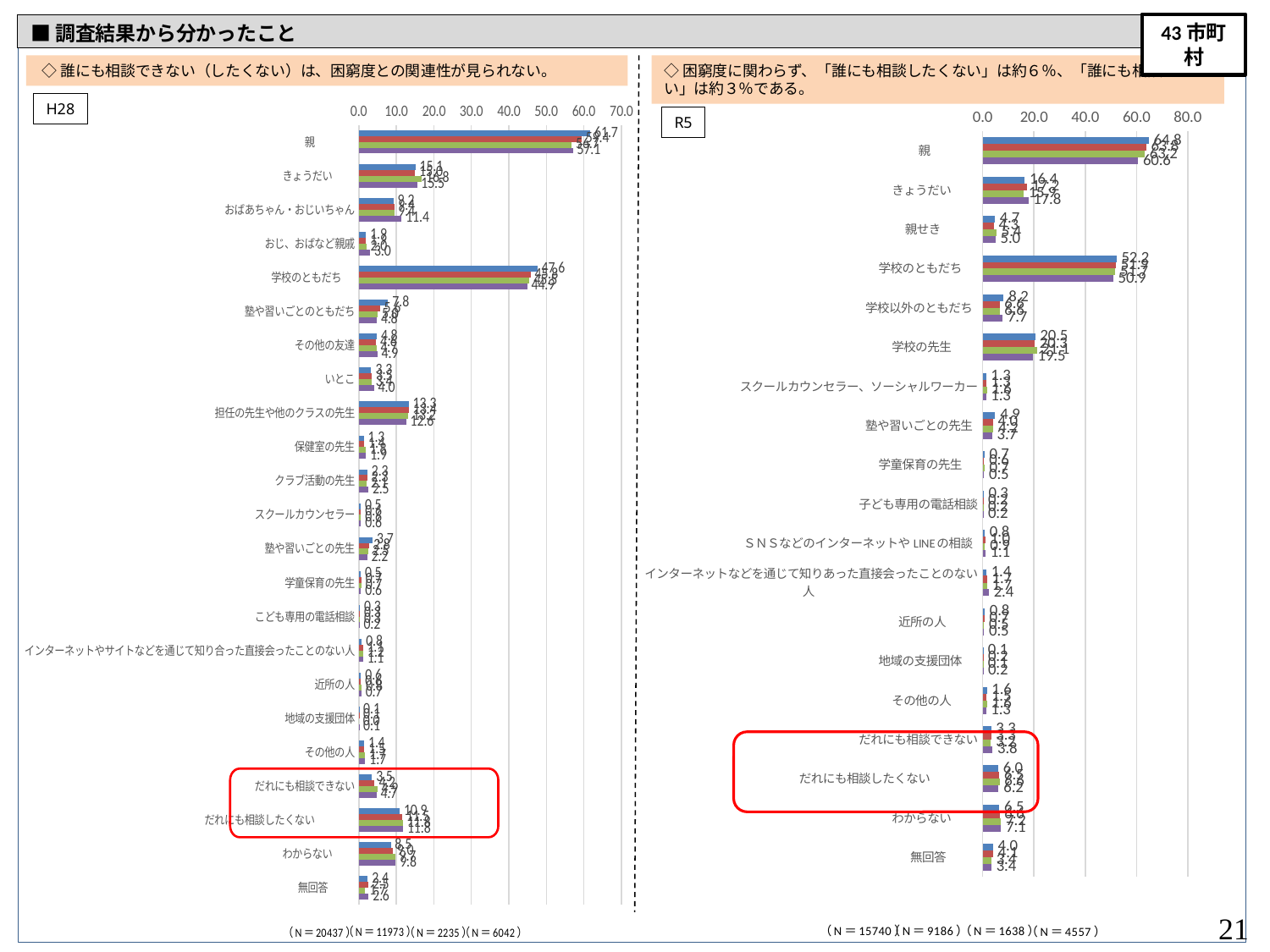
In the R5 chart, what is the value of the top (blue) bar for 学校のともだち? 52.2 In the R5 chart, what is the difference between the top (blue) bar and the bottom (purple) bar for 親? 4.2 What is the maximum value shown on the x axis of the R5 chart? 80.0 In the H28 chart, what is the value of the top (blue) bar for 親? 61.7 In the H28 chart, which is larger: the top (blue) bar for きょうだい or the top (blue) bar for 担任の先生や他のクラスの先生? きょうだい In the R5 chart, what is the value of the top (blue) bar for 親? 64.8 In the H28 chart, which category has the highest values? 親 In the R5 chart, which category has the highest values? 親 In the H28 chart, what is the value of the top (blue) bar for 学校のともだち? 47.6 In the R5 chart, is the top (blue) bar for 学校の先生 greater or less than 20.0? greater How many categories are listed on the R5 chart? 19 What type of chart is the H28 chart on the left? bar chart